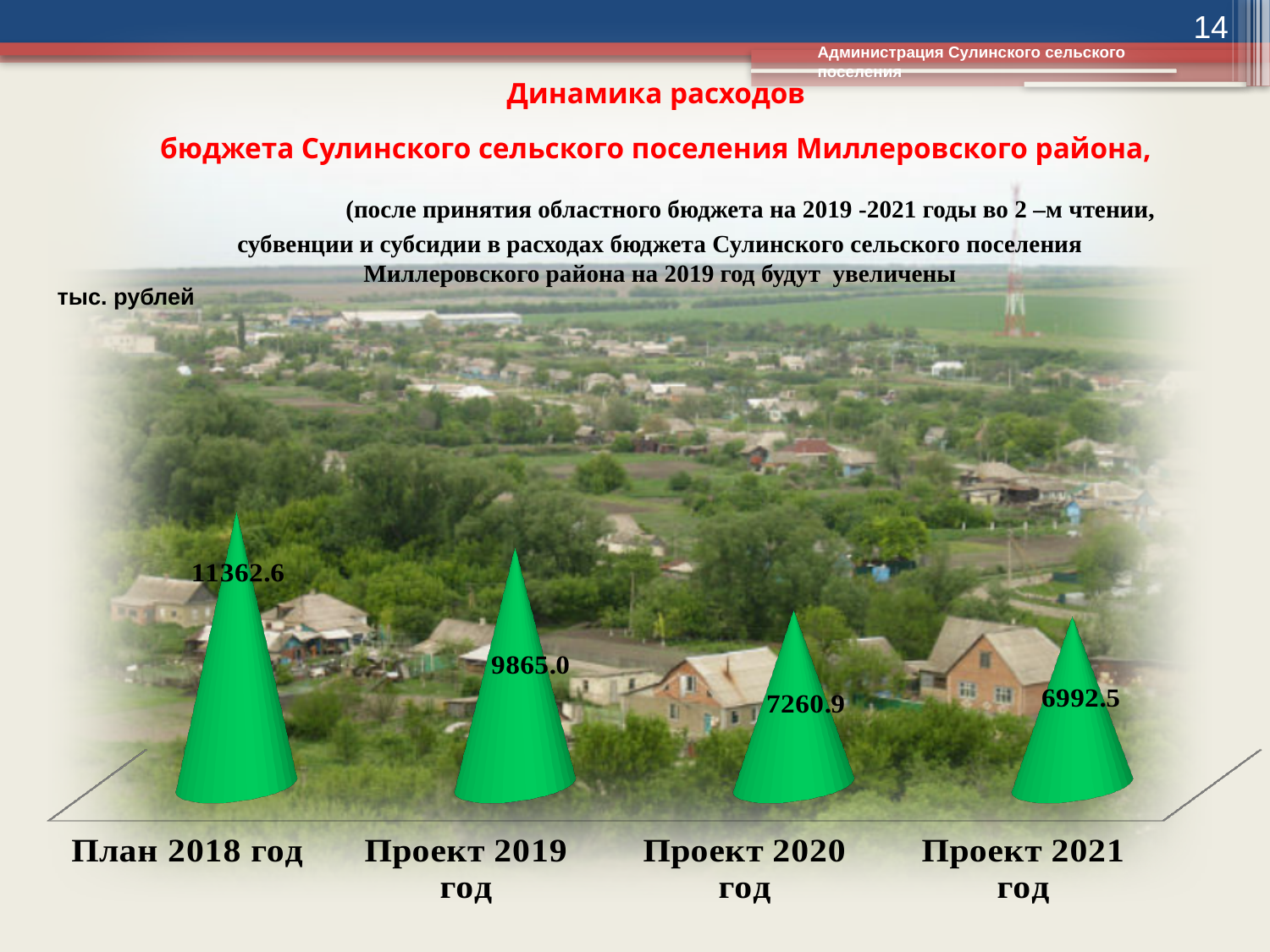
How many categories are shown in the chart? 4 What is the value for План 2018 год? 11362.6 What is the value for Проект 2019 год? 9865.0 Which category has the highest value? План 2018 год What is the value for Проект 2020 год? 7260.9 What is the value for Проект 2021 год? 6992.5 Which category has the lowest value? Проект 2021 год What is the difference between the values for План 2018 год and Проект 2019 год? 1497.6 Do the values rise or fall from План 2018 год to Проект 2021 год? fall Which is larger, the value for Проект 2019 год or Проект 2020 год? Проект 2019 год What is the difference between the values for Проект 2020 год and Проект 2021 год? 268.4 In what units are the chart values given? тыс. рублей